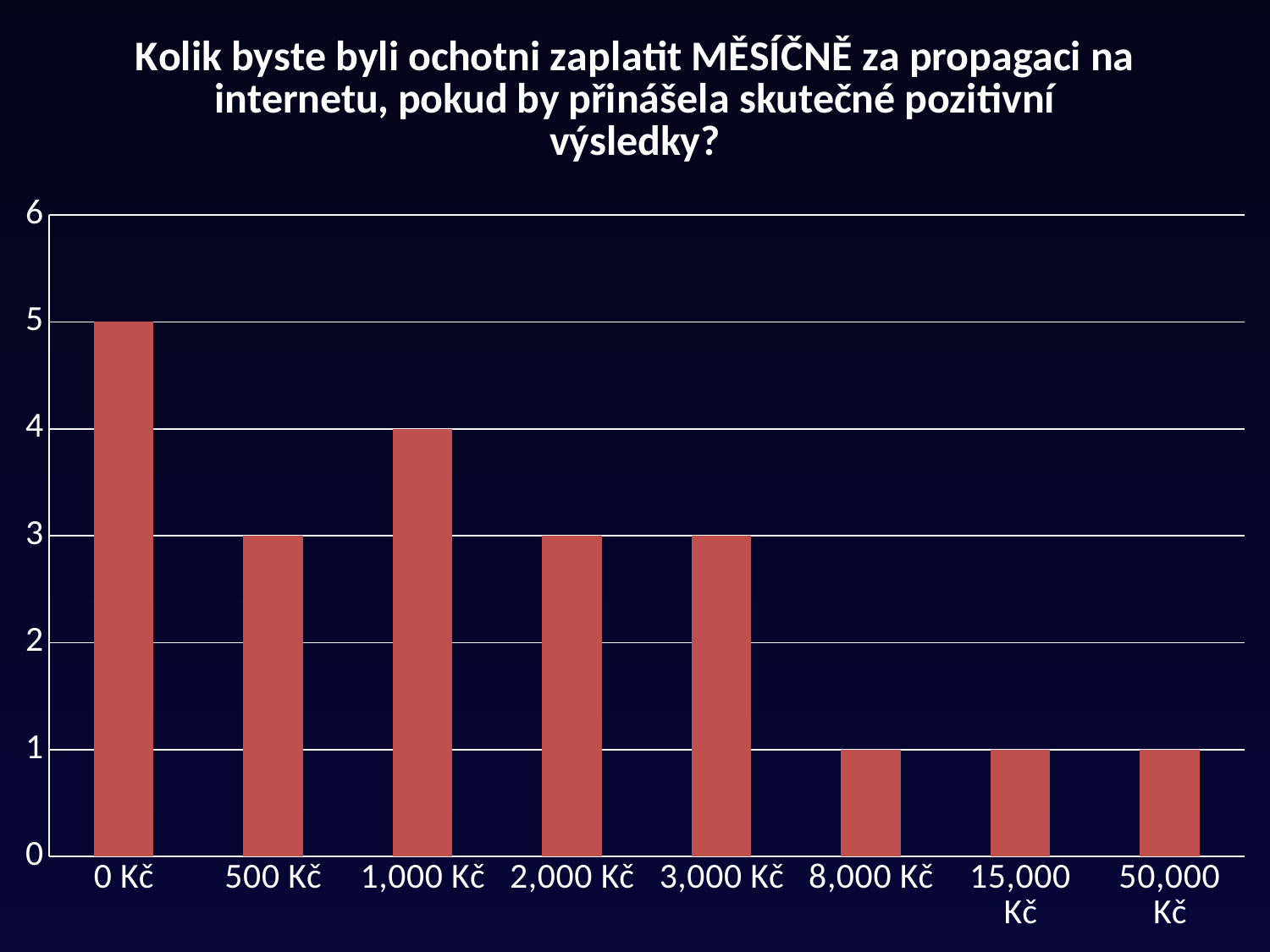
What is the value for the 1,000 Kč category? 4 What kind of chart is shown on the slide? bar chart What is the value for the 0 Kč category? 5 What is the value for the 8,000 Kč category? 1 Which category has the highest value? 0 Kč How many categories are shown on the x axis? 8 How many categories have a value of 1? 3 What is the highest value shown on the y axis? 6 Which is larger, the value for 1,000 Kč or the value for 2,000 Kč? 1,000 Kč Is the value for 3,000 Kč greater or less than 2? greater What is the difference between the values for 0 Kč and 500 Kč? 2 What colour are the bars in the chart? red